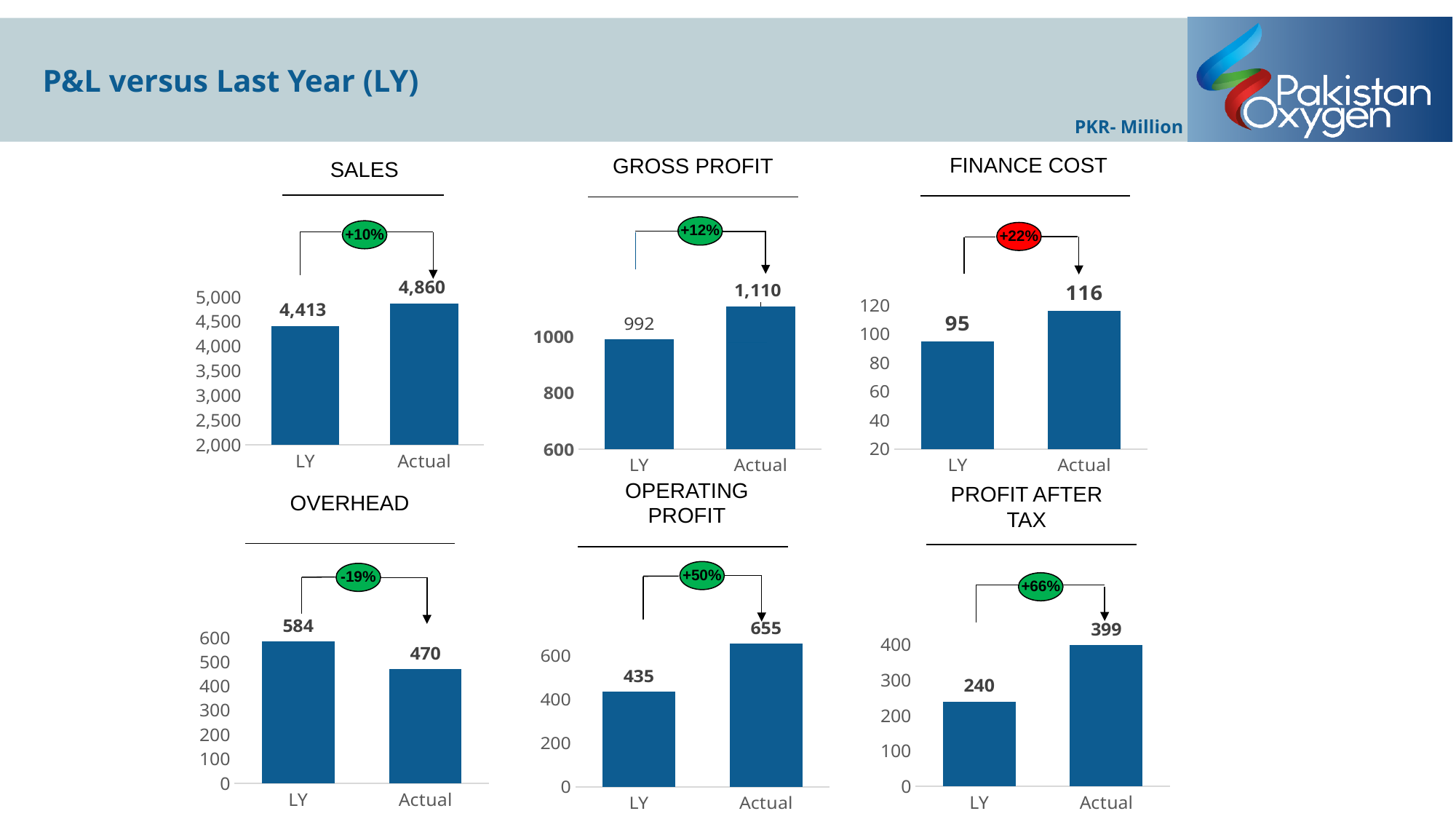
In the PROFIT AFTER TAX chart, what is the value for LY? 240 In the OPERATING PROFIT chart, what is the value for Actual? 655 In the OVERHEAD chart, what is the difference between LY and Actual? 114 In the SALES chart, what is the value for Actual? 4,860 How many charts are shown on the slide? 6 In the GROSS PROFIT chart, what is the value for LY? 992 In the SALES chart, what is the value for LY? 4,413 In the PROFIT AFTER TAX chart, what is the difference between Actual and LY? 159 In the FINANCE COST chart, what is the value for Actual? 116 In the GROSS PROFIT chart, what is the difference between Actual and LY? 118 In the OVERHEAD chart, which bar is higher, LY or Actual? LY What kind of chart is the SALES chart? Bar chart